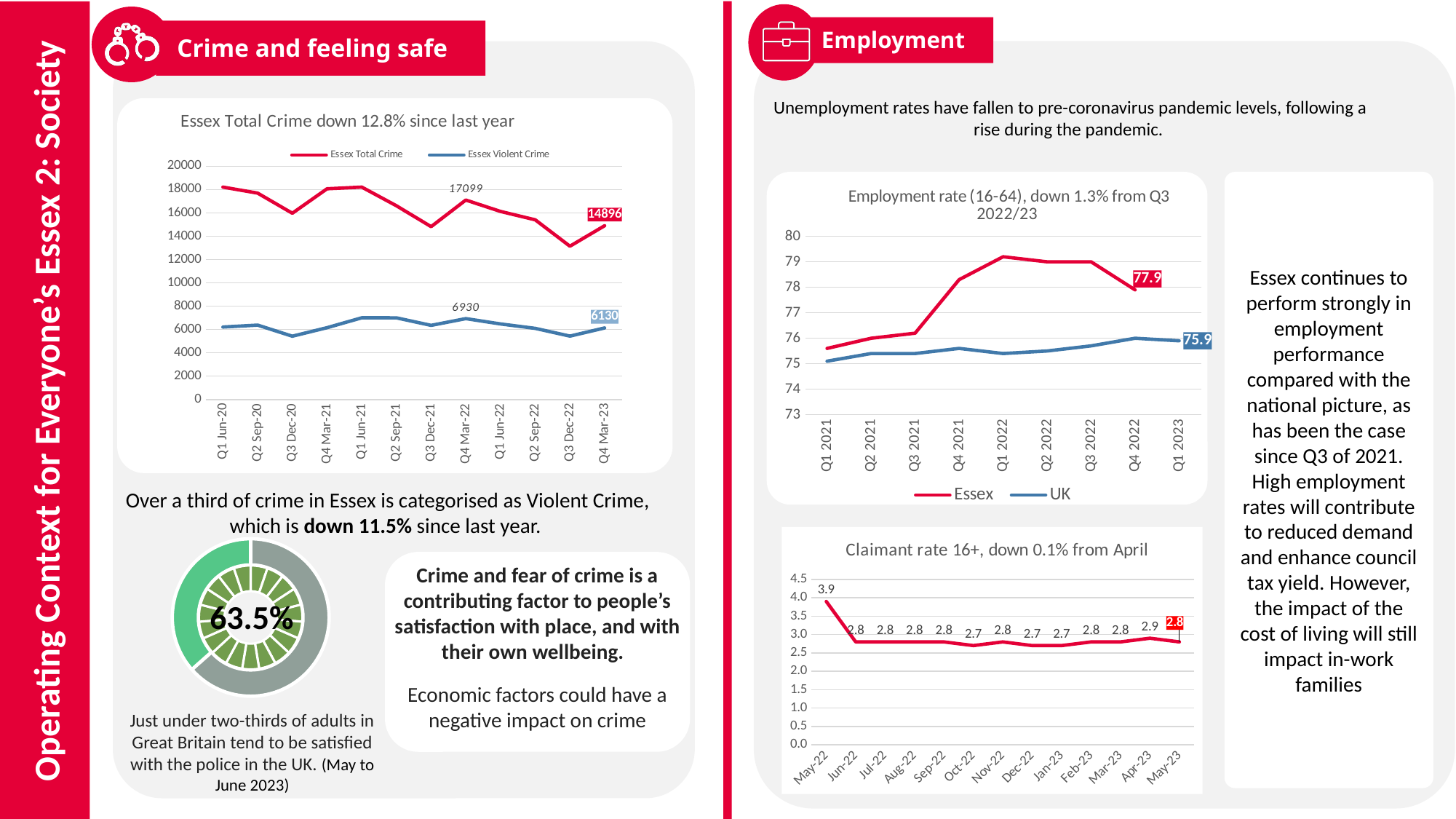
In the 'Essex Total Crime down 12.8% since last year' chart, what is the Essex Violent Crime value at Q4 Mar-22? 6930 How many quarters are shown on the x axis of the 'Essex Total Crime down 12.8% since last year' chart? 12 How many series does the legend of the 'Essex Total Crime down 12.8% since last year' chart list? 2 In the 'Claimant rate 16+, down 0.1% from April' chart, which month has the highest value? May-22 In the 'Essex Total Crime down 12.8% since last year' chart, what is the Essex Total Crime value at Q4 Mar-23? 14896 In the 'Claimant rate 16+, down 0.1% from April' chart, what is the value for Apr-23? 2.9 In the 'Employment rate (16-64), down 1.3% from Q3 2022/23' chart, what is the UK value at Q1 2023? 75.9 In the 'Essex Total Crime down 12.8% since last year' chart, what is the difference between the Essex Total Crime values at Q4 Mar-22 and Q4 Mar-23? 2203 In the 'Essex Total Crime down 12.8% since last year' chart, is the Essex Total Crime value at Q3 Dec-22 greater or less than 14000? less In the 'Claimant rate 16+, down 0.1% from April' chart, what is the difference between the May-22 and Jun-22 values? 1.1 What kind of chart is the 'Employment rate (16-64), down 1.3% from Q3 2022/23' chart? line chart In the 'Employment rate (16-64), down 1.3% from Q3 2022/23' chart, which series is higher at Q1 2022, Essex or UK? Essex